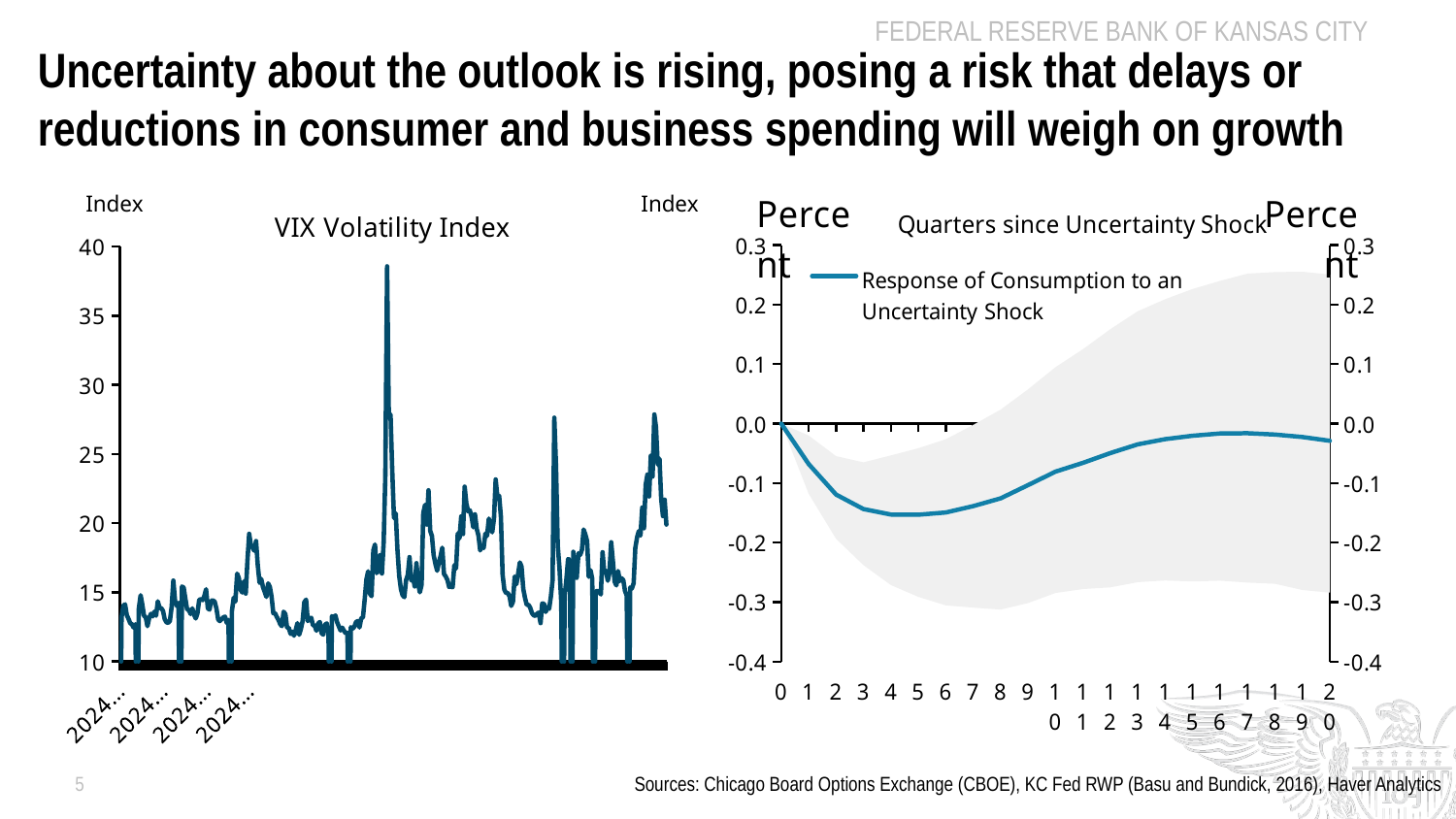
In the right-hand chart, is the response of consumption at quarter 15 greater or less than -0.1? greater What kind of chart is the right-hand chart showing the response of consumption to an uncertainty shock? line chart In the right-hand chart, is the response of consumption at quarter 4 greater or less than -0.1? less In the right-hand chart, what is the value of the response of consumption at quarter 0? 0.0 In the VIX Volatility Index chart, is the lowest point of the line greater or less than 15? less In the right-hand chart, does the response of consumption line fall or rise between quarter 0 and quarter 4? fall What is the title of the left-hand chart? VIX Volatility Index How many series does the legend of the right-hand chart list? 1 In the right-hand chart, does the response of consumption line rise or fall between quarter 5 and quarter 15? rise What is the x-axis title of the right-hand chart? Quarters since Uncertainty Shock What kind of chart is the VIX Volatility Index chart on the left? line chart